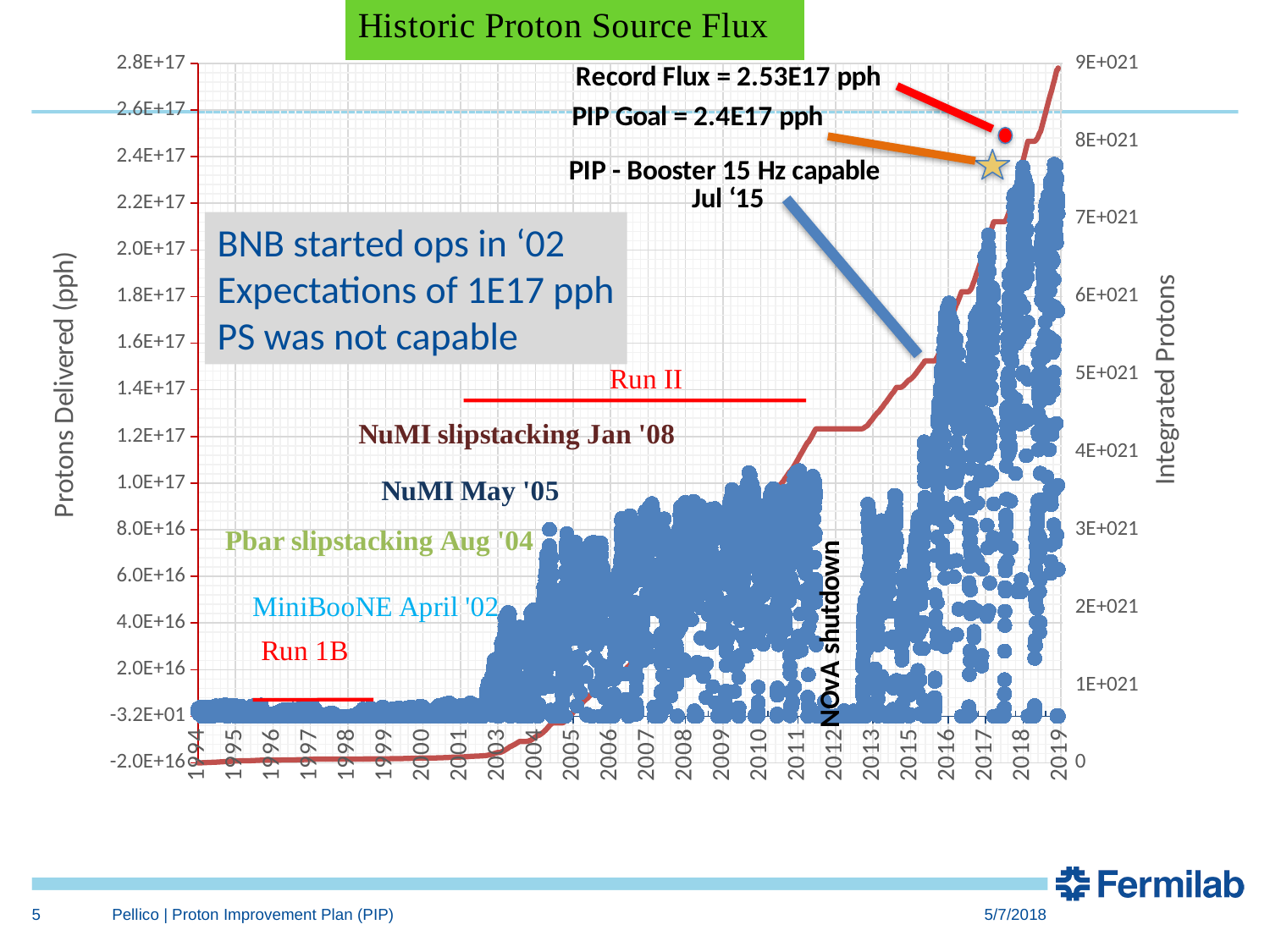
Is the Integrated Protons value during the 2012 NOvA shutdown greater or less than 5E+021? less Is the Integrated Protons value during the 2012 NOvA shutdown greater or less than 3E+021? greater Which is larger, the annotated Record Flux or the annotated PIP Goal? Record Flux What is the difference between the annotated Record Flux and the PIP Goal? 1.3E16 pph What record flux value is annotated on the chart? 2.53E17 pph What is the title of the chart? Historic Proton Source Flux What is the label of the left vertical axis? Protons Delivered (pph) What kind of chart is used to show the protons delivered data? scatter chart How many year labels are shown on the x axis? 24 Is the Integrated Protons value at the end of 2019 greater or less than 8E+021? greater Does the Integrated Protons line rise or fall from 1994 to 2019? rise What PIP goal value is annotated on the chart? 2.4E17 pph